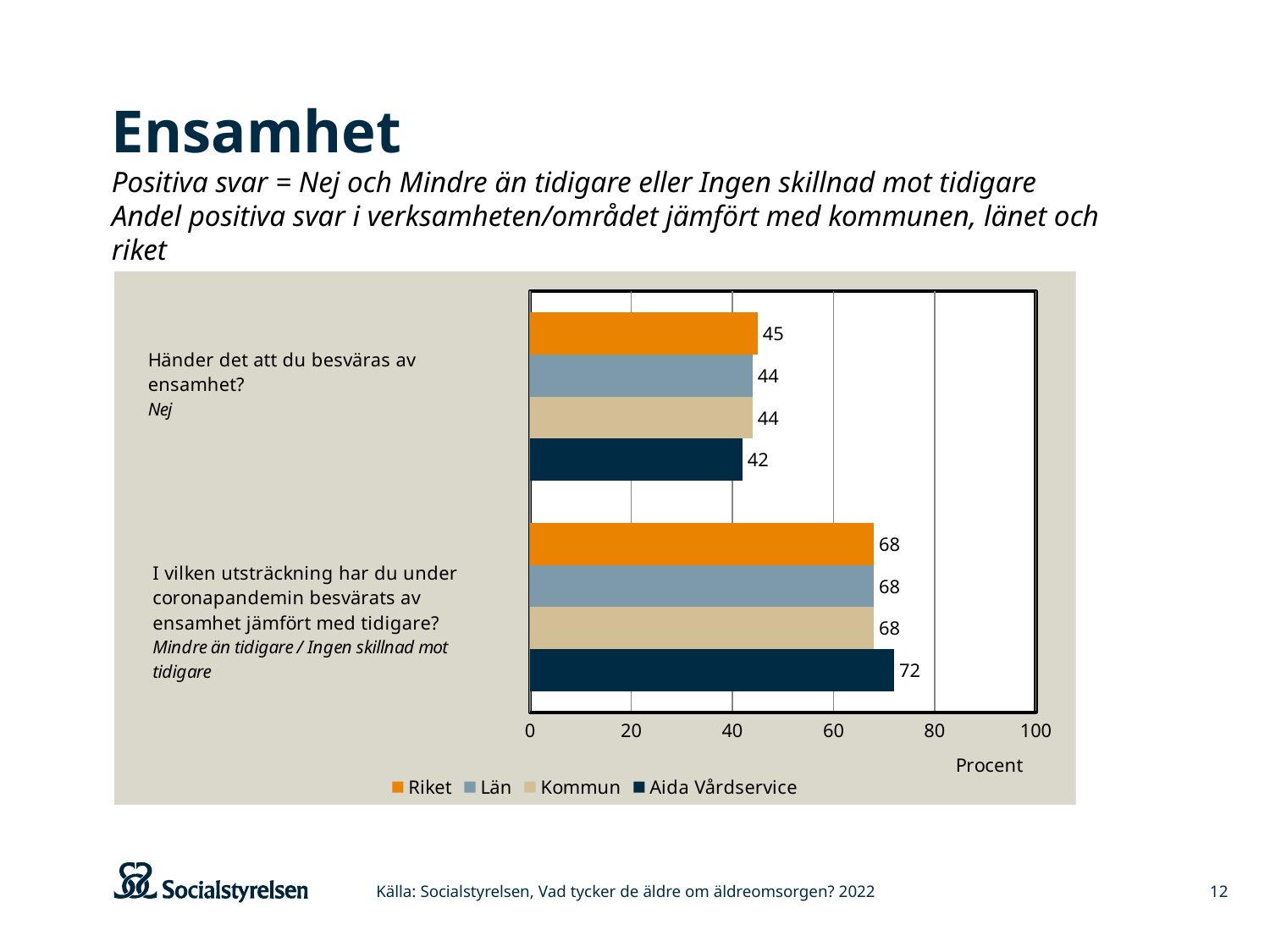
What is the value for Kommun on the question "I vilken utsträckning har du under coronapandemin besvärats av ensamhet jämfört med tidigare?"? 68 What type of chart is shown on the slide? bar chart How many series does the legend list? 4 What is the value for Riket on the question "Händer det att du besväras av ensamhet?"? 45 What is the label on the horizontal axis of the chart? Procent Which series has the highest value on the question "I vilken utsträckning har du under coronapandemin besvärats av ensamhet jämfört med tidigare?"? Aida Vårdservice Which series has the lowest value on the question "Händer det att du besväras av ensamhet?"? Aida Vårdservice Which is larger for Aida Vårdservice: the value for "Händer det att du besväras av ensamhet?" or the value for "I vilken utsträckning har du under coronapandemin besvärats av ensamhet jämfört med tidigare?"? I vilken utsträckning har du under coronapandemin besvärats av ensamhet jämfört med tidigare? What is the value for Aida Vårdservice on the question "Händer det att du besväras av ensamhet?"? 42 What is the difference between Aida Vårdservice and Riket on the question "I vilken utsträckning har du under coronapandemin besvärats av ensamhet jämfört med tidigare?"? 4 How many questions (categories) are shown on the chart? 2 What is the value for Aida Vårdservice on the question "I vilken utsträckning har du under coronapandemin besvärats av ensamhet jämfört med tidigare?"? 72